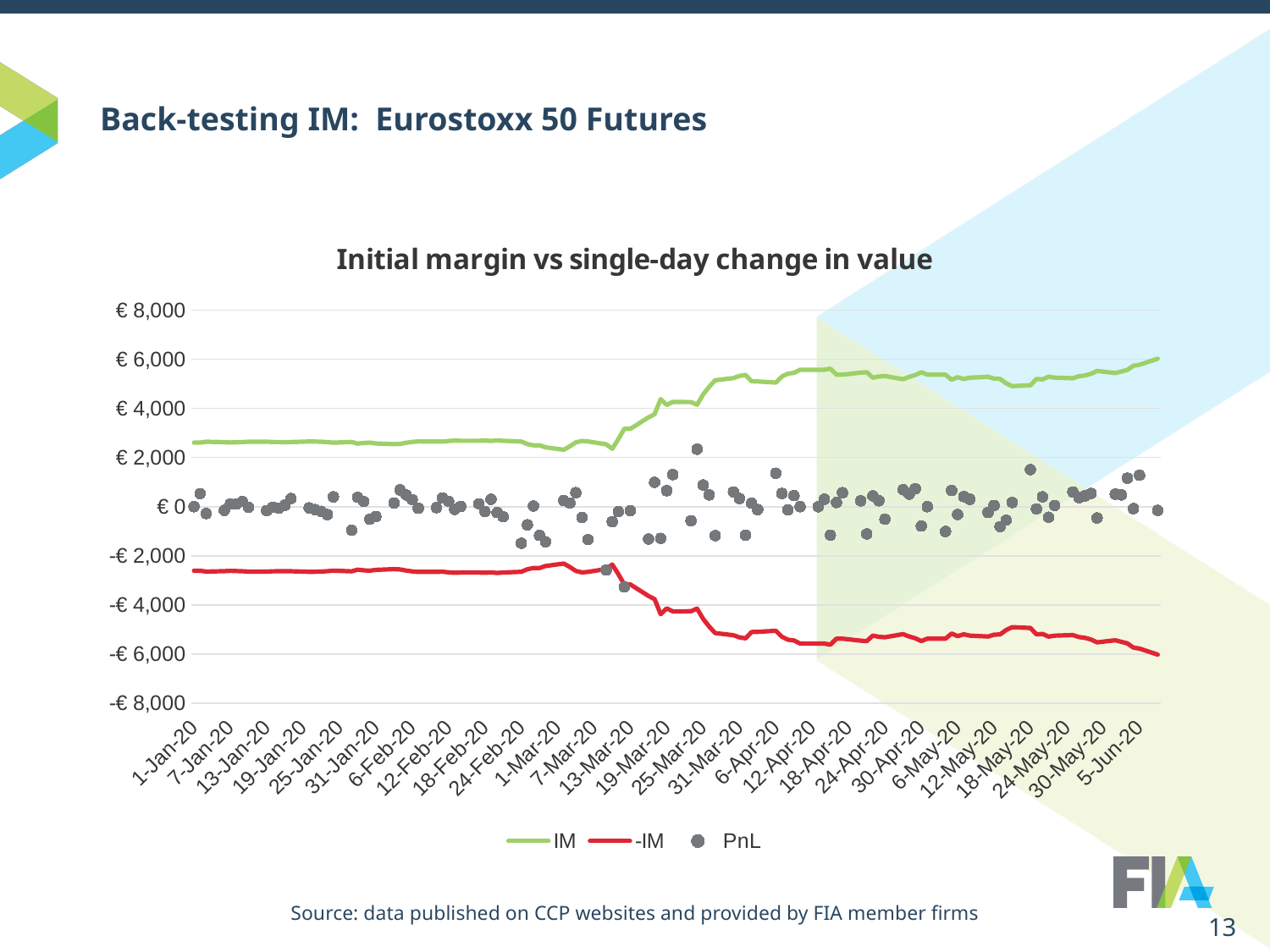
Is the -IM value on 5-Jun-20 greater or less than -€ 4,000? less What is the title of the chart? Initial margin vs single-day change in value Does the IM series rise or fall from 1-Jan-20 to 5-Jun-20? rise Does the -IM series rise or fall from 1-Jan-20 to 5-Jun-20? fall Is the -IM value on 1-Jan-20 greater or less than -€ 2,000? less How many series does the legend list? 3 Which is larger, the IM value on 1-Jan-20 or the IM value on 5-Jun-20? 5-Jun-20 Is the IM value on 5-Jun-20 greater or less than € 4,000? greater What kind of chart is shown on the slide? line chart Which series has the highest values on the chart? IM What are the three series named in the legend? IM, -IM, PnL